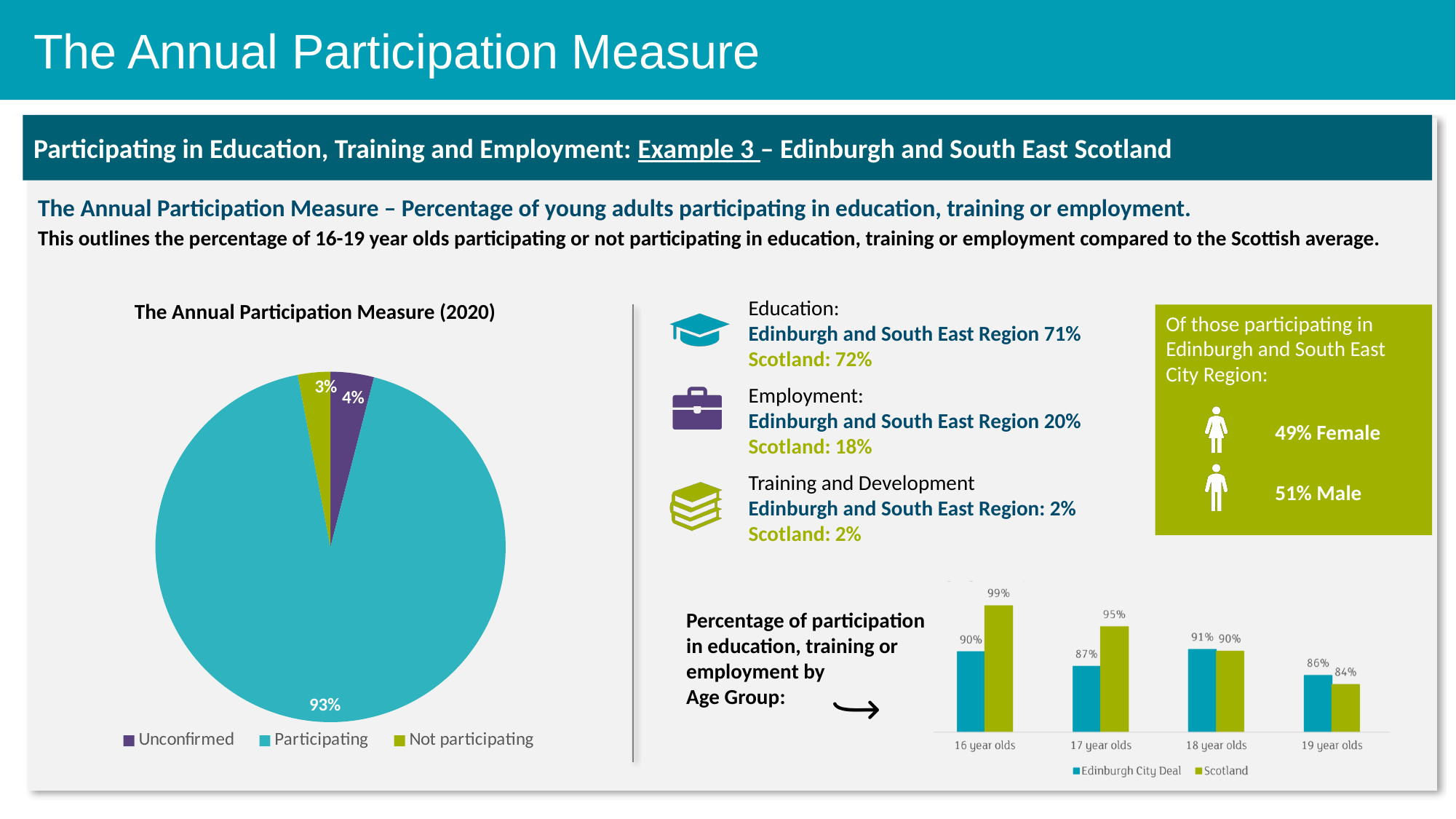
In the pie chart titled 'The Annual Participation Measure (2020)', how many categories does the legend list? 3 What kind of chart is 'The Annual Participation Measure (2020)'? Pie chart In the bar chart of participation by age group, what is the value for Scotland for 16 year olds? 99% In the pie chart titled 'The Annual Participation Measure (2020)', which category has the smallest slice? Not participating In the bar chart of participation by age group, which is larger for 19 year olds: Edinburgh City Deal or Scotland? Edinburgh City Deal In the bar chart of participation by age group, how many series does the legend list? 2 In the pie chart titled 'The Annual Participation Measure (2020)', what share is labelled for Unconfirmed? 4% In the bar chart of participation by age group, what is the value for Edinburgh City Deal for 17 year olds? 87% In the pie chart titled 'The Annual Participation Measure (2020)', what share is labelled for Participating? 93% In the bar chart of participation by age group, do the Scotland values rise or fall from 16 year olds to 19 year olds? Fall In the bar chart of participation by age group, which age group has the highest Scotland value? 16 year olds In the bar chart of participation by age group, what is the difference between the Scotland and Edinburgh City Deal values for 16 year olds? 9%